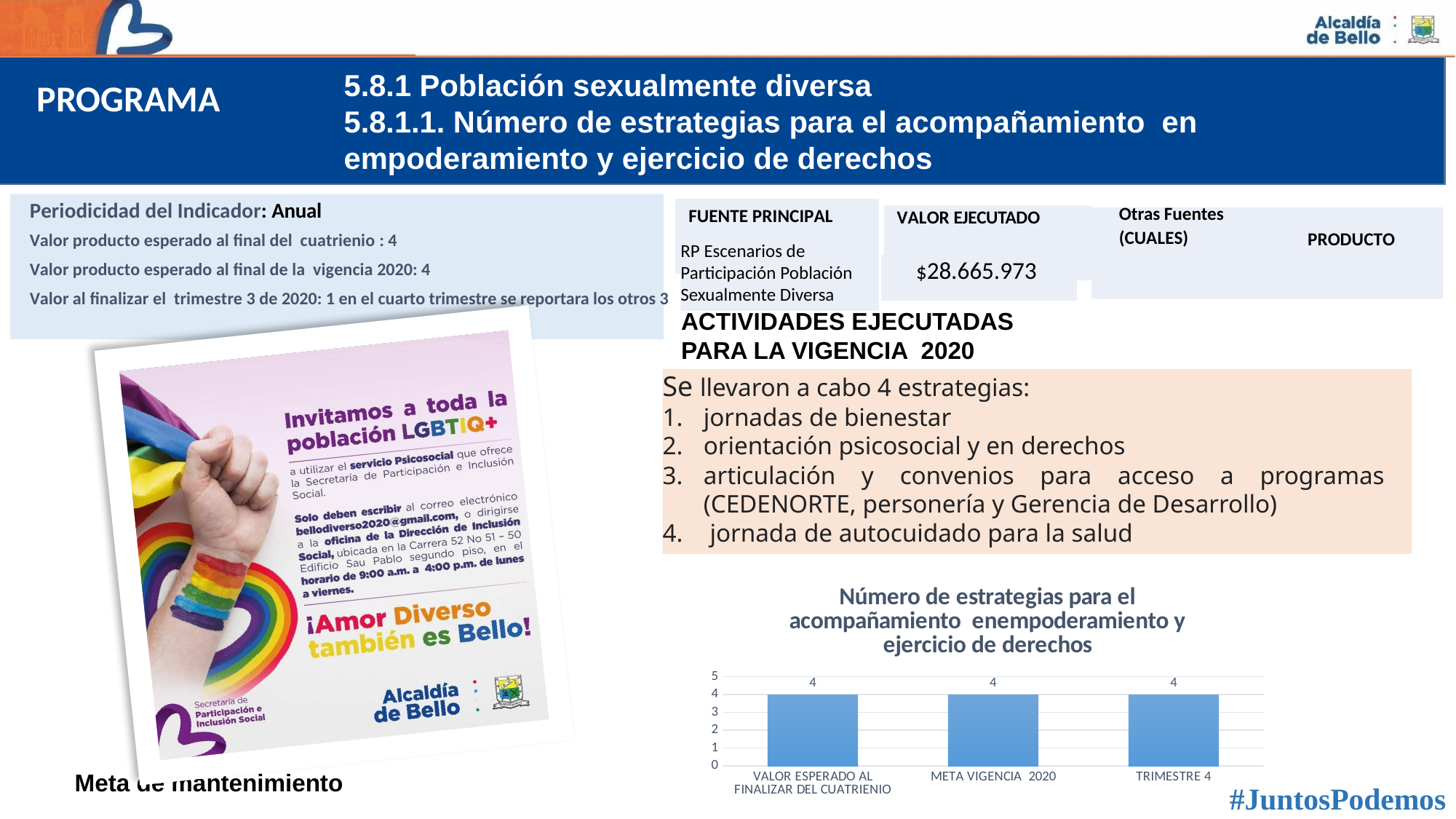
What is the title of the chart? Número de estrategias para el acompañamiento enempoderamiento y ejercicio de derechos What is the value for META VIGENCIA 2020 in the chart? 4 Is the value for TRIMESTRE 4 greater or less than 3? greater What is the highest value shown on the y axis of the chart? 5 What is the difference between the value for META VIGENCIA 2020 and the value for TRIMESTRE 4? 0 Do the values rise, fall, or stay the same across the categories from left to right? stay the same What kind of chart is shown on the slide? bar chart Is the value for VALOR ESPERADO AL FINALIZAR DEL CUATRIENIO greater or less than 5? less What is the value for TRIMESTRE 4 in the chart? 4 How many categories are shown on the x axis of the chart? 3 What is the value for VALOR ESPERADO AL FINALIZAR DEL CUATRIENIO in the chart? 4